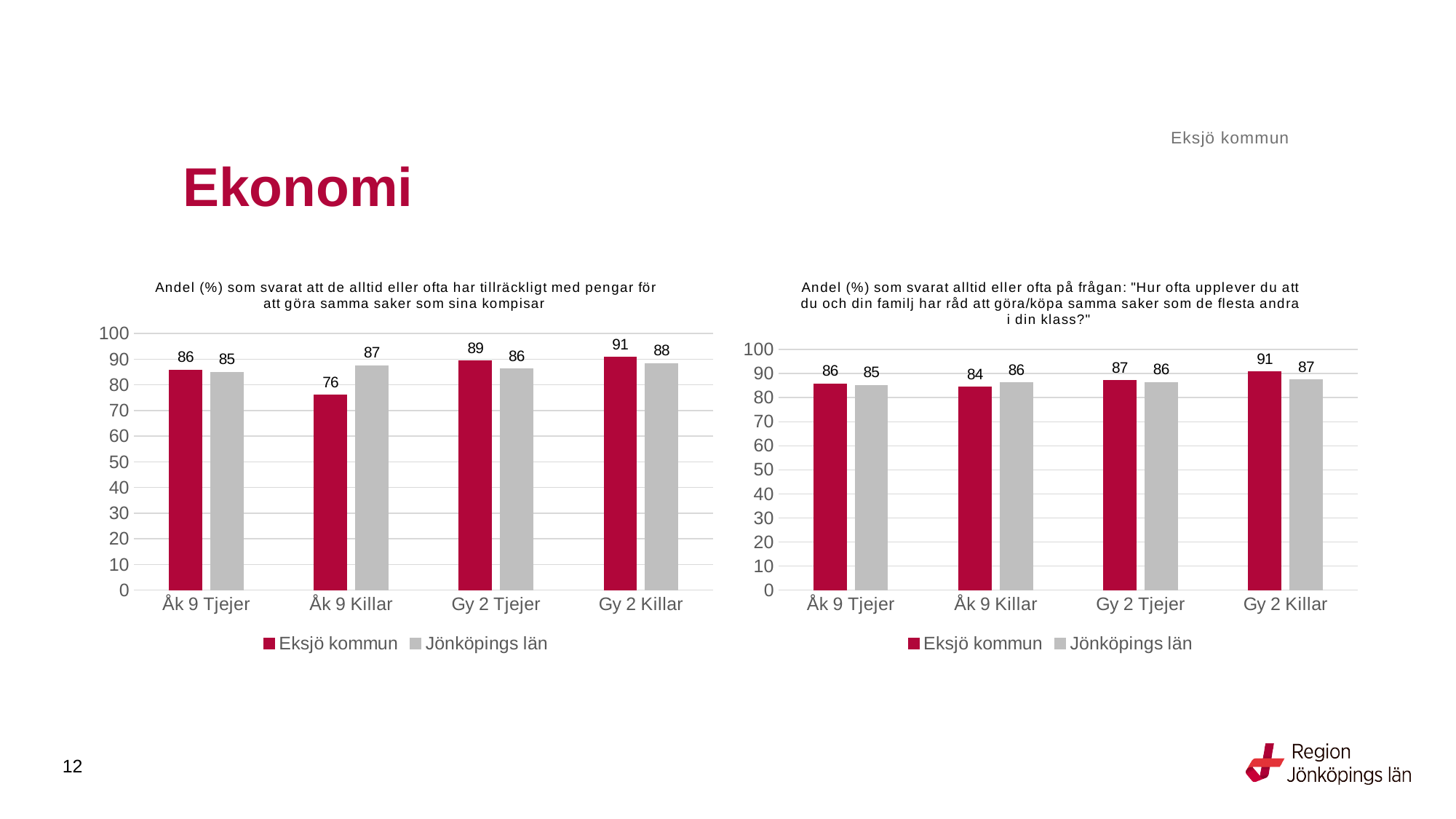
In the left chart, which category has the lowest value for Eksjö kommun? Åk 9 Killar How many series does the legend of the left chart list? 2 In the right chart, which category has the highest value for Eksjö kommun? Gy 2 Killar In the right chart, what is the value for Jönköpings län for Åk 9 Killar? 86 In the left chart, what is the value for Jönköpings län for Gy 2 Killar? 88 In the left chart, what is the difference between Jönköpings län and Eksjö kommun for Åk 9 Killar? 11 How many categories are shown on the x axis of the right chart? 4 In the right chart, what is the value for Eksjö kommun for Gy 2 Tjejer? 87 In the right chart, what is the difference between Eksjö kommun and Jönköpings län for Gy 2 Killar? 4 What kind of chart is the left chart? Bar chart In the left chart, what is the value for Eksjö kommun for Åk 9 Killar? 76 In the left chart, which is larger for Gy 2 Tjejer: Eksjö kommun or Jönköpings län? Eksjö kommun